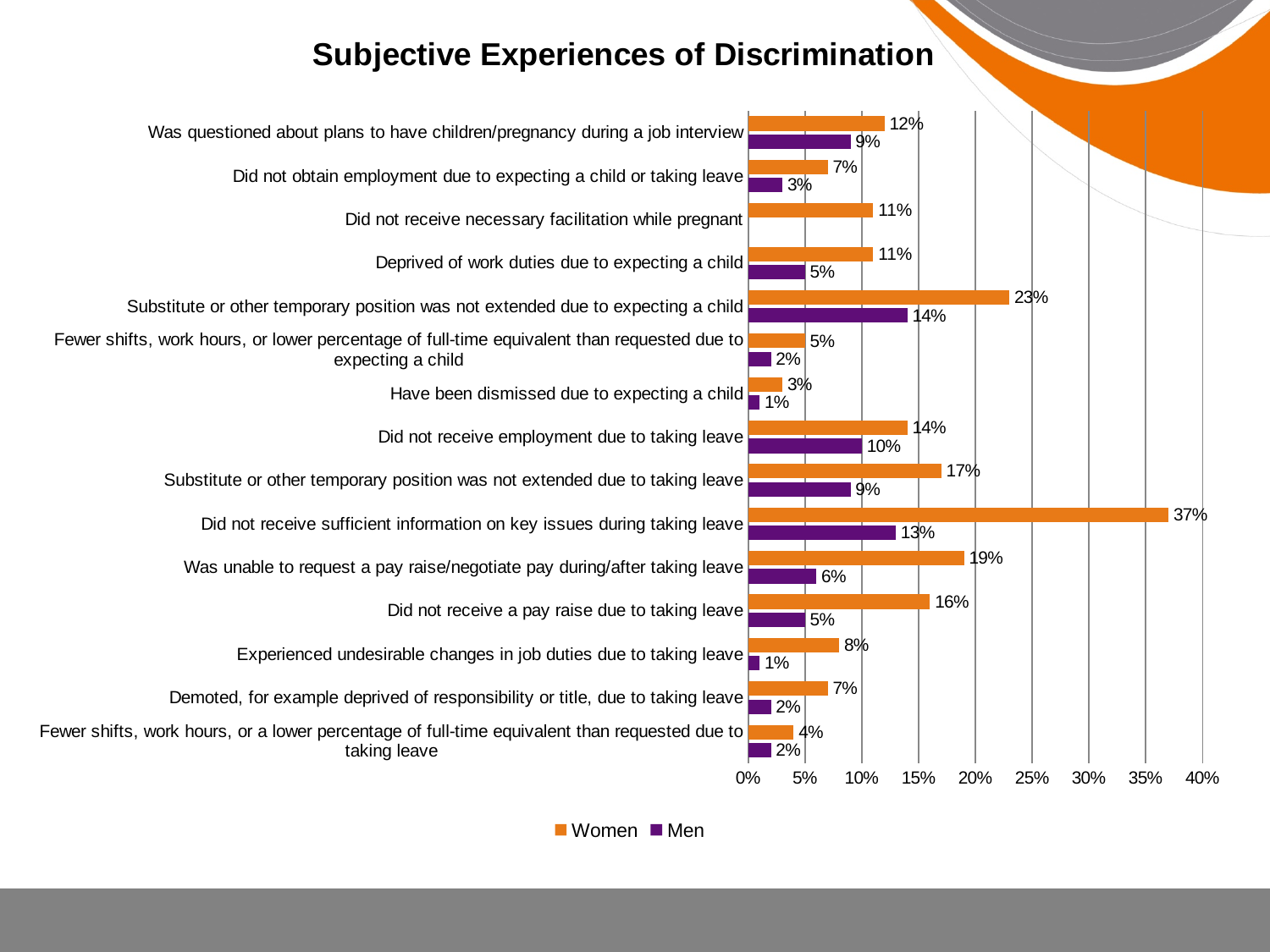
What is the value for Women for 'Did not receive sufficient information on key issues during taking leave'? 37% How many series does the legend list? 2 What is the title of the chart? Subjective Experiences of Discrimination How many categories are shown on the chart? 15 What is the difference between the Women and Men values for 'Was unable to request a pay raise/negotiate pay during/after taking leave'? 13% Which category has the highest value for Women? Did not receive sufficient information on key issues during taking leave What type of chart is shown on the slide? Bar chart What is the value for Men for 'Was questioned about plans to have children/pregnancy during a job interview'? 9% Which category has the lowest value for Women? Have been dismissed due to expecting a child Which category has the highest value for Men? Substitute or other temporary position was not extended due to expecting a child What is the value for Men for 'Substitute or other temporary position was not extended due to expecting a child'? 14% Which is larger: the Women value for 'Did not receive a pay raise due to taking leave' or the Women value for 'Did not receive employment due to taking leave'? Did not receive a pay raise due to taking leave